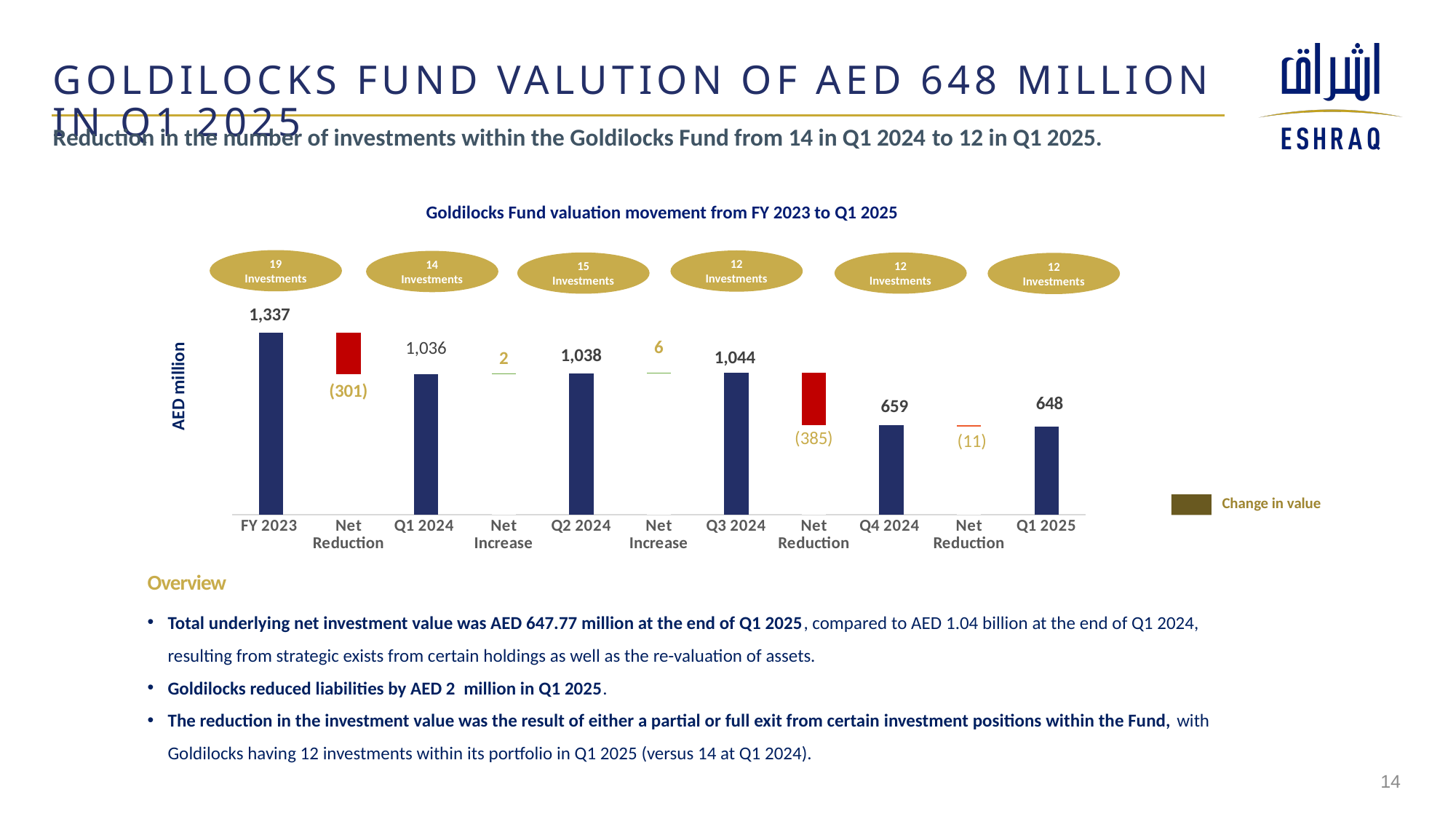
What is the Goldilocks Fund valuation for FY 2023 in the chart? 1,337 Which period has the highest valuation bar in the chart? FY 2023 What is the valuation shown for Q1 2025? 648 Which is larger, the valuation for Q1 2024 or for Q2 2024? Q2 2024 What is the difference between the FY 2023 valuation and the Q1 2025 valuation? 689 How many categories are shown along the x axis of the chart? 11 Which period-end valuation bar is the lowest in the chart? Q1 2025 What is the net increase shown between Q2 2024 and Q3 2024? 6 What kind of chart is used to show the valuation movement? Bar chart What is the label on the vertical axis of the chart? AED million What value is labelled for Q3 2024? 1,044 What is the net reduction shown between Q3 2024 and Q4 2024? (385)